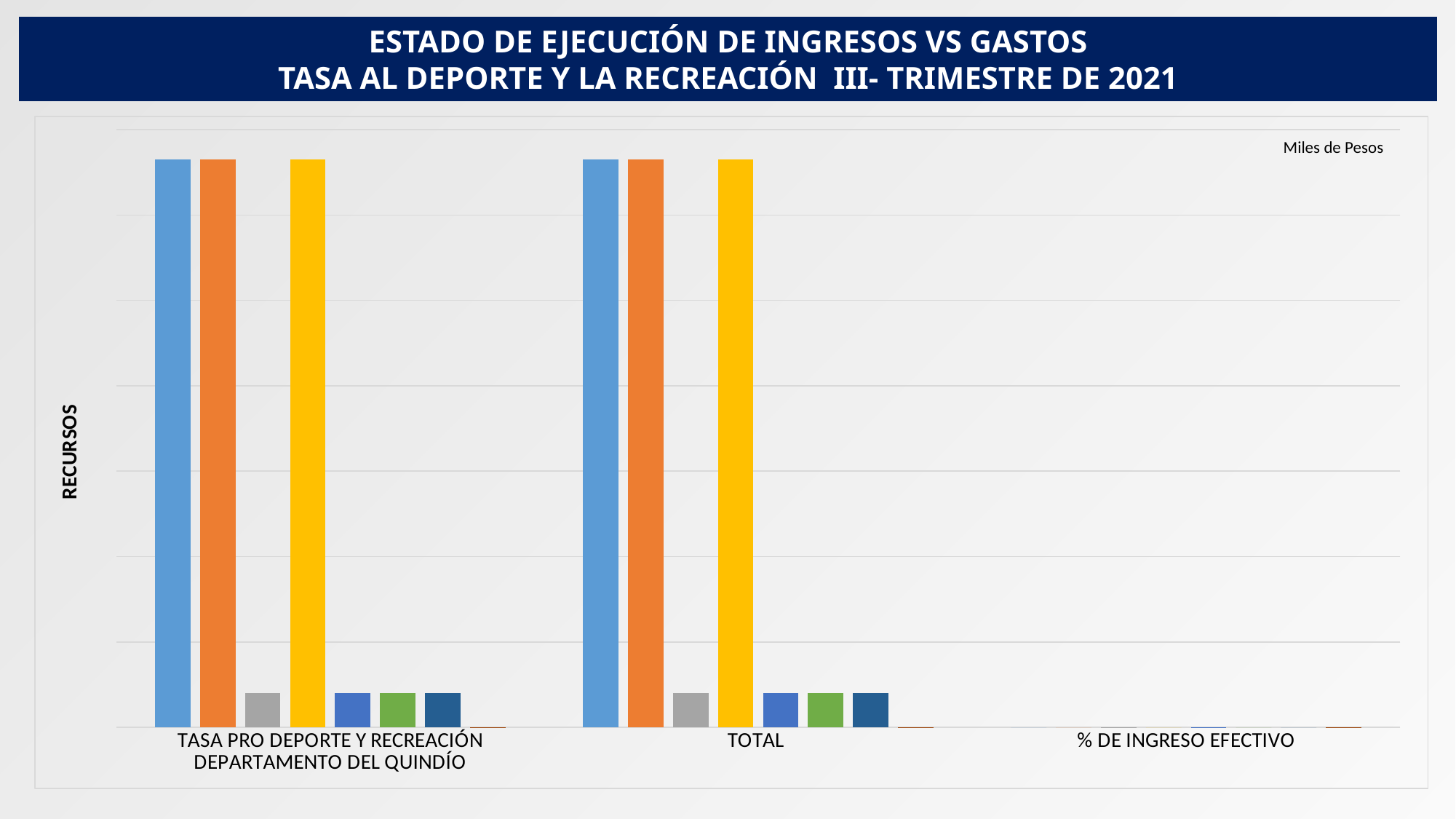
In the TOTAL category, which bar is taller, the yellow bar or the gray bar? the yellow bar What is the label of the second category on the x axis? TOTAL How many categories are shown on the x axis of the chart? 3 What is the title of the chart? ESTADO DE EJECUCIÓN DE INGRESOS VS GASTOS TASA AL DEPORTE Y LA RECREACIÓN III- TRIMESTRE DE 2021 In the TASA PRO DEPORTE Y RECREACIÓN DEPARTAMENTO DEL QUINDÍO category, which bar is taller, the orange bar or the green bar? the orange bar What is the label on the vertical axis of the chart? RECURSOS What kind of chart is shown on the slide? bar chart What is the label of the third category on the x axis? % DE INGRESO EFECTIVO Which category on the x axis has the smallest bars? % DE INGRESO EFECTIVO